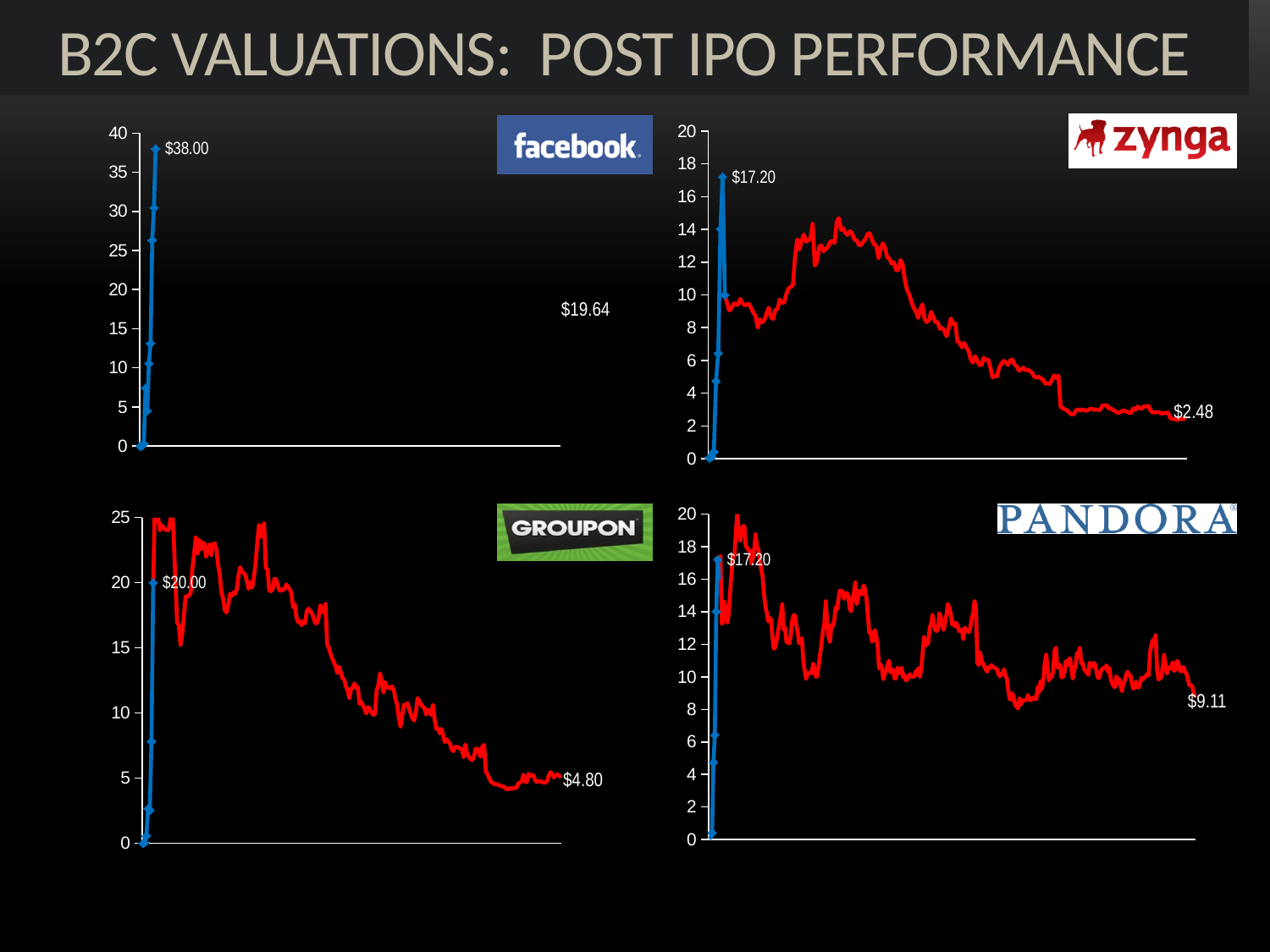
On the Pandora chart, does the red line generally rise or fall from left to right? fall Which chart has a higher ending value printed on its red line, Zynga or Pandora? Pandora On the Groupon chart, what is the value printed at the end of the red line? $4.80 On the Facebook chart, what is the value printed at the top of the blue line? $38.00 On the Zynga chart, what is the value printed at the end of the red line? $2.48 On the Groupon chart, what is the value printed at the top of the blue line? $20.00 On the Facebook chart, what is the second value printed on the chart? $19.64 On the Zynga chart, what is the difference between the starting value $17.20 and the ending value $2.48? $14.72 On the Groupon chart, what is the difference between the starting value $20.00 and the ending value $4.80? $15.20 On the Zynga chart, what is the value printed at the start of the red line? $17.20 On the Pandora chart, what is the value printed at the end of the red line? $9.11 What kind of chart is the Zynga chart? line chart